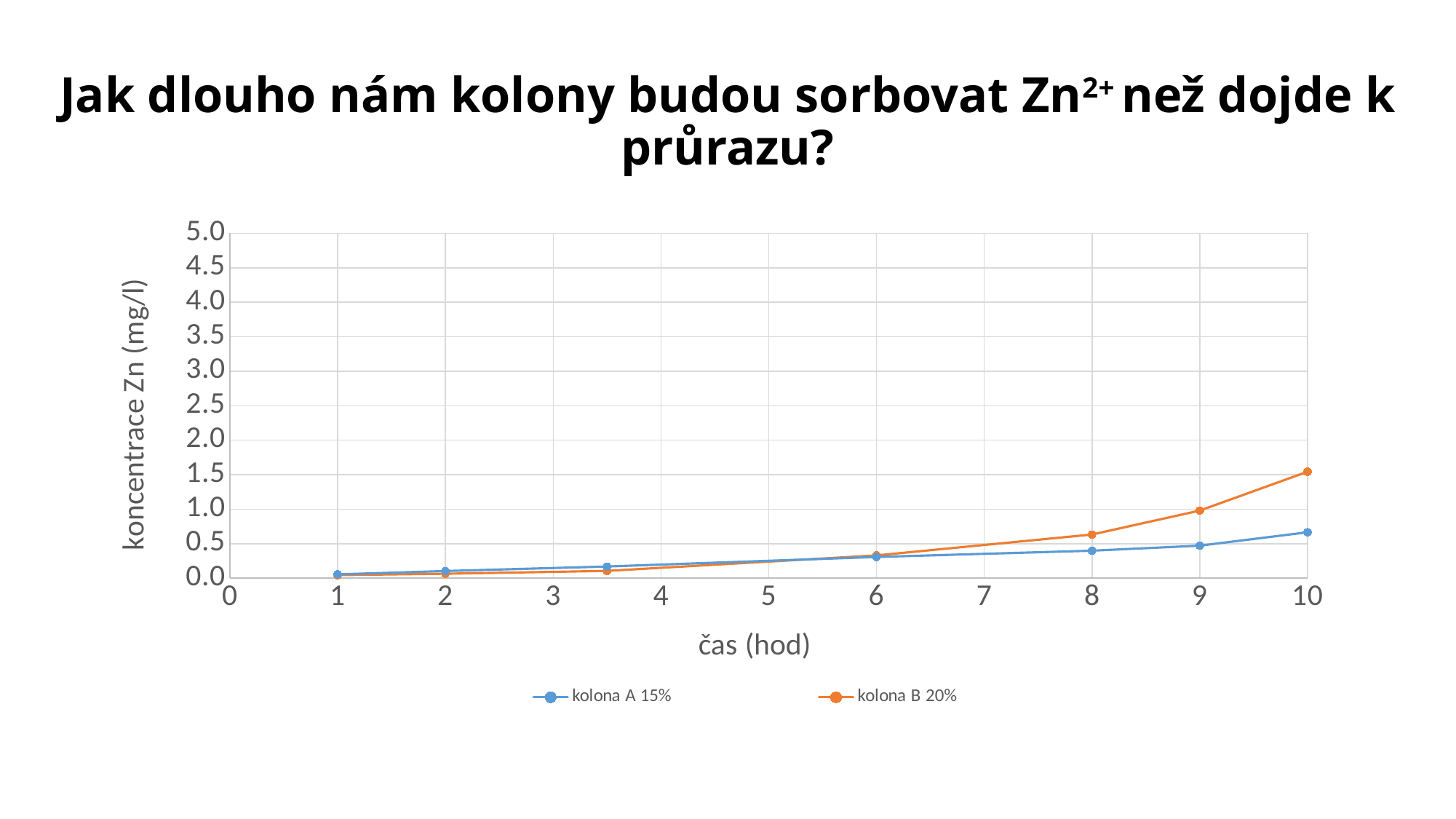
At which time (hod) does kolona B 20% reach its highest value? 10 Is the value for kolona B 20% at 9 hours greater or less than 0.5? greater How many data points are plotted for the series kolona B 20%? 7 What kind of chart is shown on the slide? line chart Which series reaches the highest Zn concentration on the chart? kolona B 20% Is the value for kolona A 15% at 8 hours greater or less than 0.5? less How many series does the legend list? 2 Is the value for kolona B 20% at 10 hours greater or less than 1.0? greater At 10 hours, which series has the higher Zn concentration, kolona A 15% or kolona B 20%? kolona B 20% Do the values for kolona B 20% rise or fall as time increases? rise What is the label of the y axis? koncentrace Zn (mg/l)